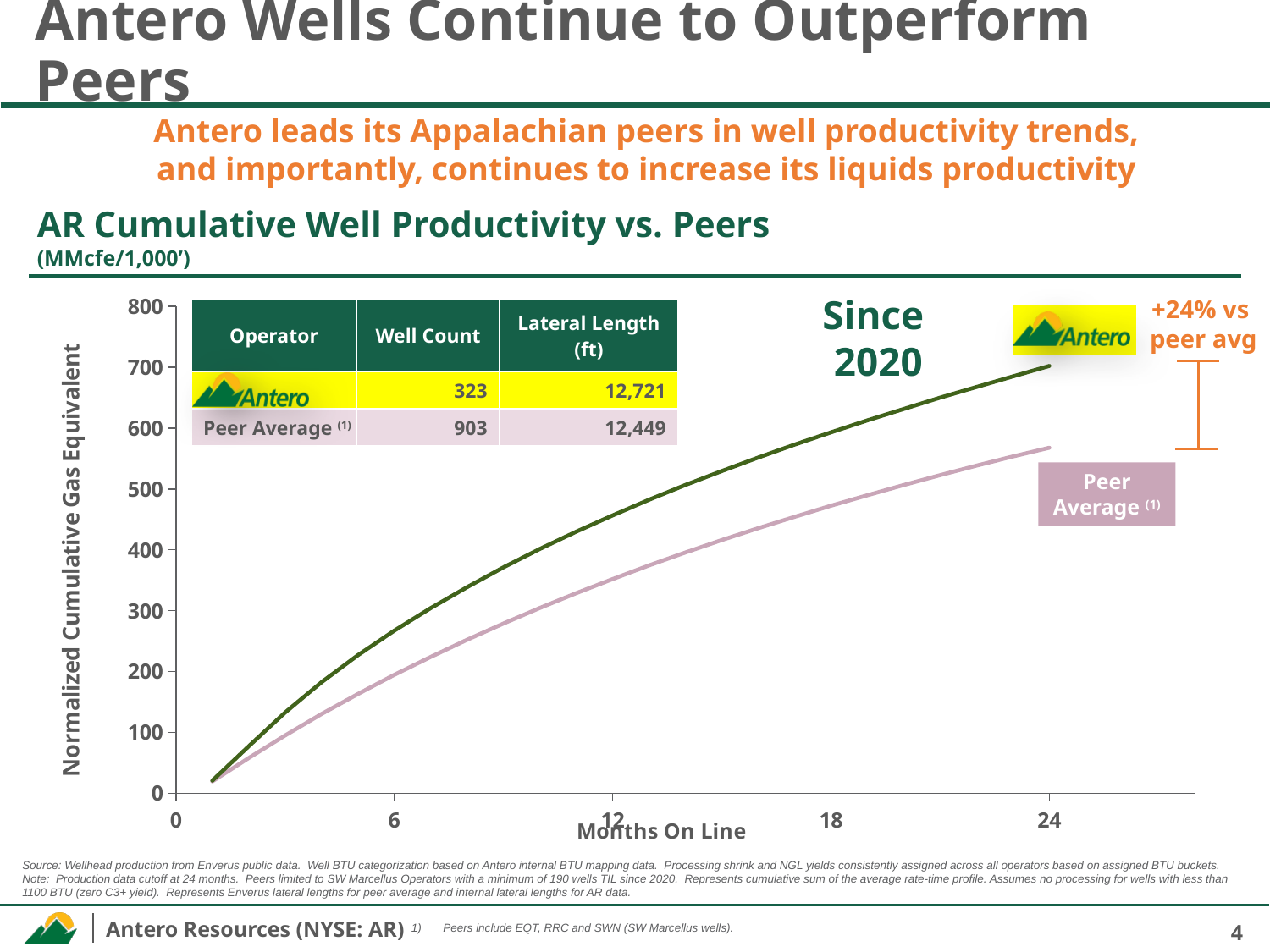
By what percentage does Antero outperform the peer average according to the annotation on the chart? +24% What kind of chart is shown on the slide? line chart Is the value for Peer Average at 24 months on line greater or less than 500? greater Do the values for Antero rise or fall as months on line increase? rise Which series has the higher value at 24 months on line, Antero or Peer Average? Antero Is the value for Peer Average at 12 months on line greater or less than 400? less What is the label of the x axis of the chart? Months On Line According to the table on the chart, what is the well count for Antero? 323 Is the value for Antero at 6 months on line greater or less than 400? less How many series are plotted on the chart? 2 According to the table on the chart, what is the lateral length (ft) for Peer Average? 12,449